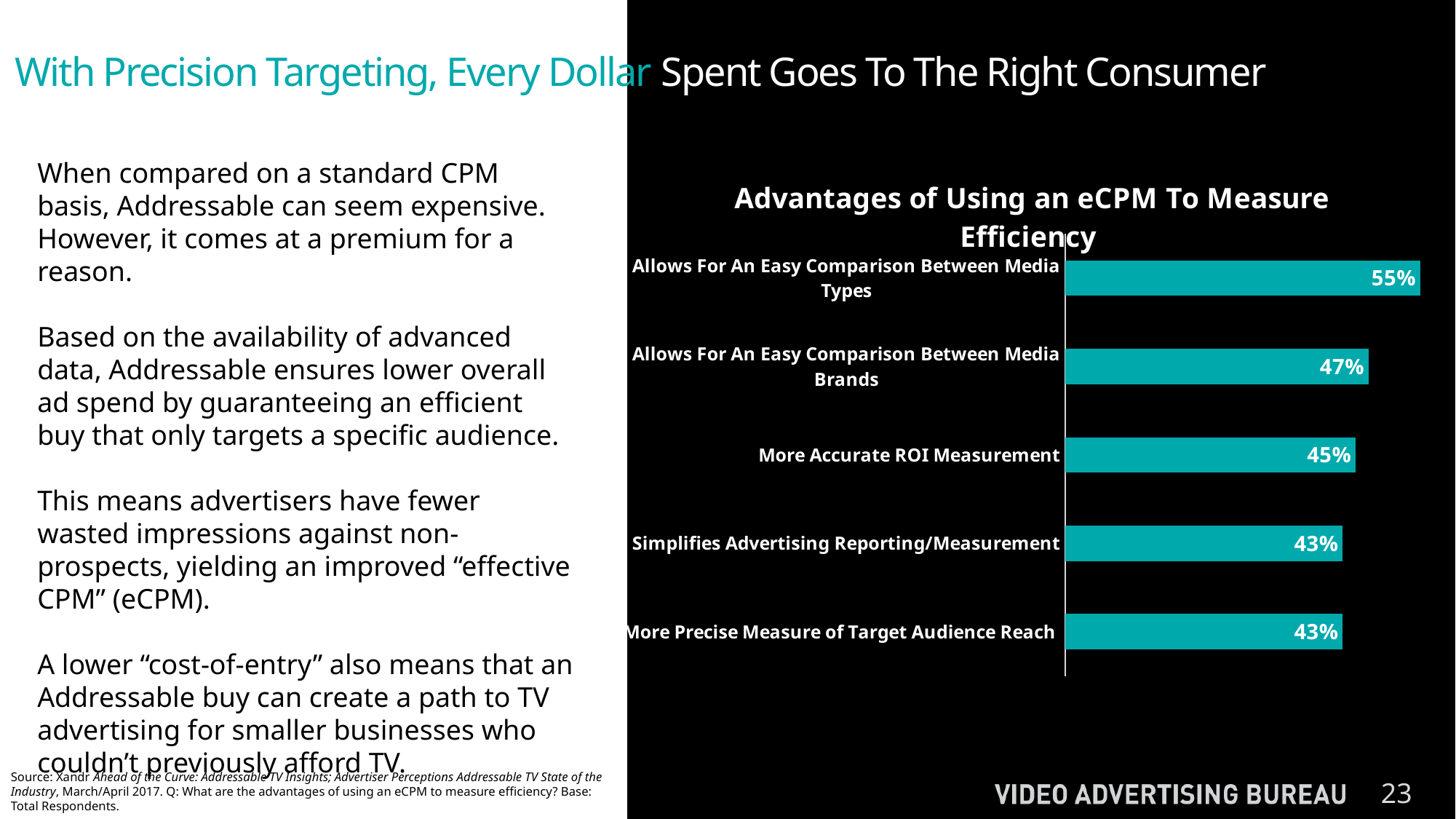
Which two categories share the same value of 43%? Simplifies Advertising Reporting/Measurement and More Precise Measure of Target Audience Reach What is the difference between the values for "Allows For An Easy Comparison Between Media Types" and "Allows For An Easy Comparison Between Media Brands"? 8% How many categories are shown in the chart? 5 What is the value for "Allows For An Easy Comparison Between Media Brands"? 47% What is the value for "Simplifies Advertising Reporting/Measurement"? 43% What is the difference between the values for "More Accurate ROI Measurement" and "More Precise Measure of Target Audience Reach"? 2% Which category has the highest value? Allows For An Easy Comparison Between Media Types Which is larger: the value for "Allows For An Easy Comparison Between Media Brands" or the value for "More Accurate ROI Measurement"? Allows For An Easy Comparison Between Media Brands What is the title of the chart? Advantages of Using an eCPM To Measure Efficiency What is the value for "More Accurate ROI Measurement"? 45% What kind of chart is shown on the slide? Bar chart What is the value for "Allows For An Easy Comparison Between Media Types"? 55%